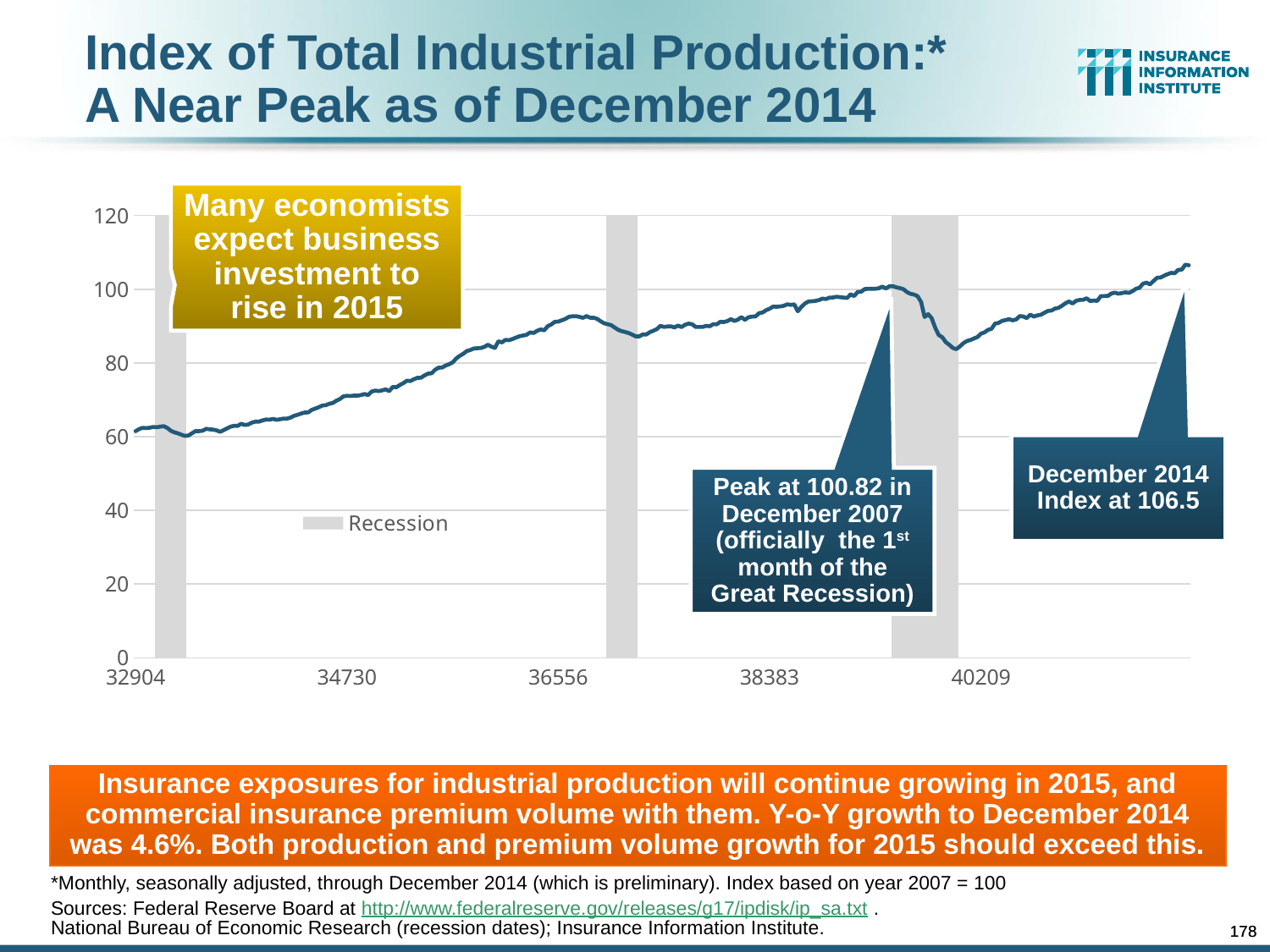
Which is larger: the index in December 2014 or the peak in December 2007? December 2014 What was the peak value of the index in December 2007? 100.82 What was the Index of Total Industrial Production in December 2014? 106.5 Is the value of the index at the left end of the line (at 32904) greater or less than 80? less According to the callout, in which month and year did the index peak at 100.82? December 2007 How much higher is the December 2014 index (106.5) than the December 2007 peak (100.82)? 5.68 Is the value of the index at the x-axis tick 40209 greater or less than 100? less Over the whole period shown, does the index generally rise or fall from left to right? rise What does the gray shading in the chart represent, according to the legend? Recession How many gray shaded recession bands are shown on the chart? 3 Is the value of the index at the x-axis tick 36556 greater or less than 80? greater What kind of chart is shown on the slide? line chart